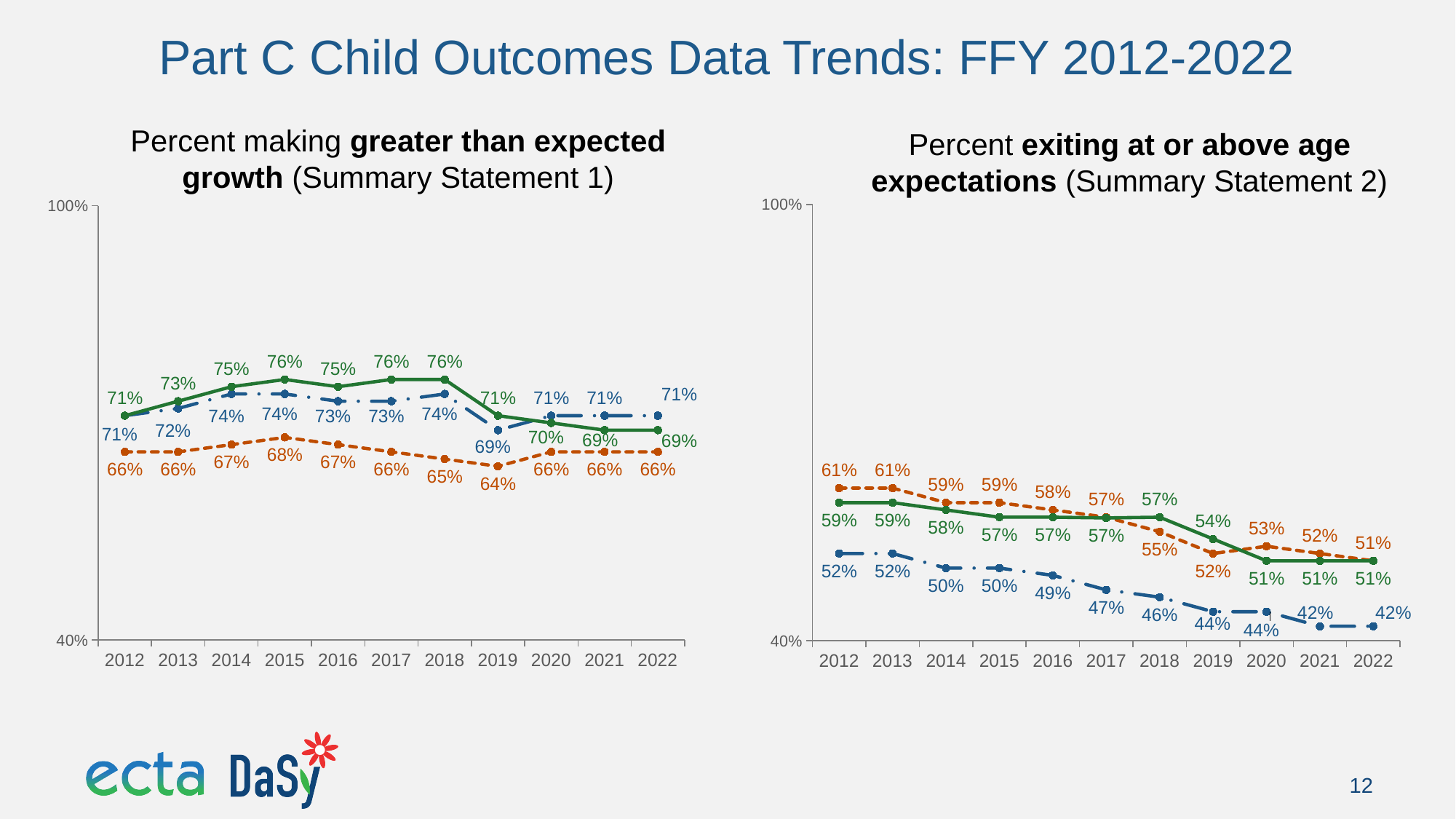
In the Summary Statement 1 chart on the left, which line has the higher value in 2018, the green solid line or the orange dashed line? Green solid line In the Summary Statement 1 chart on the left, by how many percentage points did the green solid line drop from 2018 to 2019? 5 percentage points In the Summary Statement 2 chart on the right, does the blue dash-dot line generally rise or fall from 2012 to 2022? Fall In the Summary Statement 2 chart on the right, what is the value of the blue dash-dot line in 2022? 42% In the Summary Statement 1 chart on the left, what is the highest value reached by the green solid line? 76% In the Summary Statement 2 chart on the right, by how many percentage points did the orange dashed line fall from 2012 to 2022? 10 percentage points In the Summary Statement 1 chart on the left, in which year does the orange dashed line reach its lowest value? 2019 In the Summary Statement 1 chart on the left, how many lines are plotted? 3 In the Summary Statement 1 chart on the left, what is the value of the green solid line in 2015? 76% What kind of chart is used on this slide for the Summary Statement 1 and Summary Statement 2 data? Line chart In the Summary Statement 2 chart on the right, what is the value of the green solid line in 2019? 54% In the Summary Statement 1 chart on the left, how many years are shown on the x axis? 11